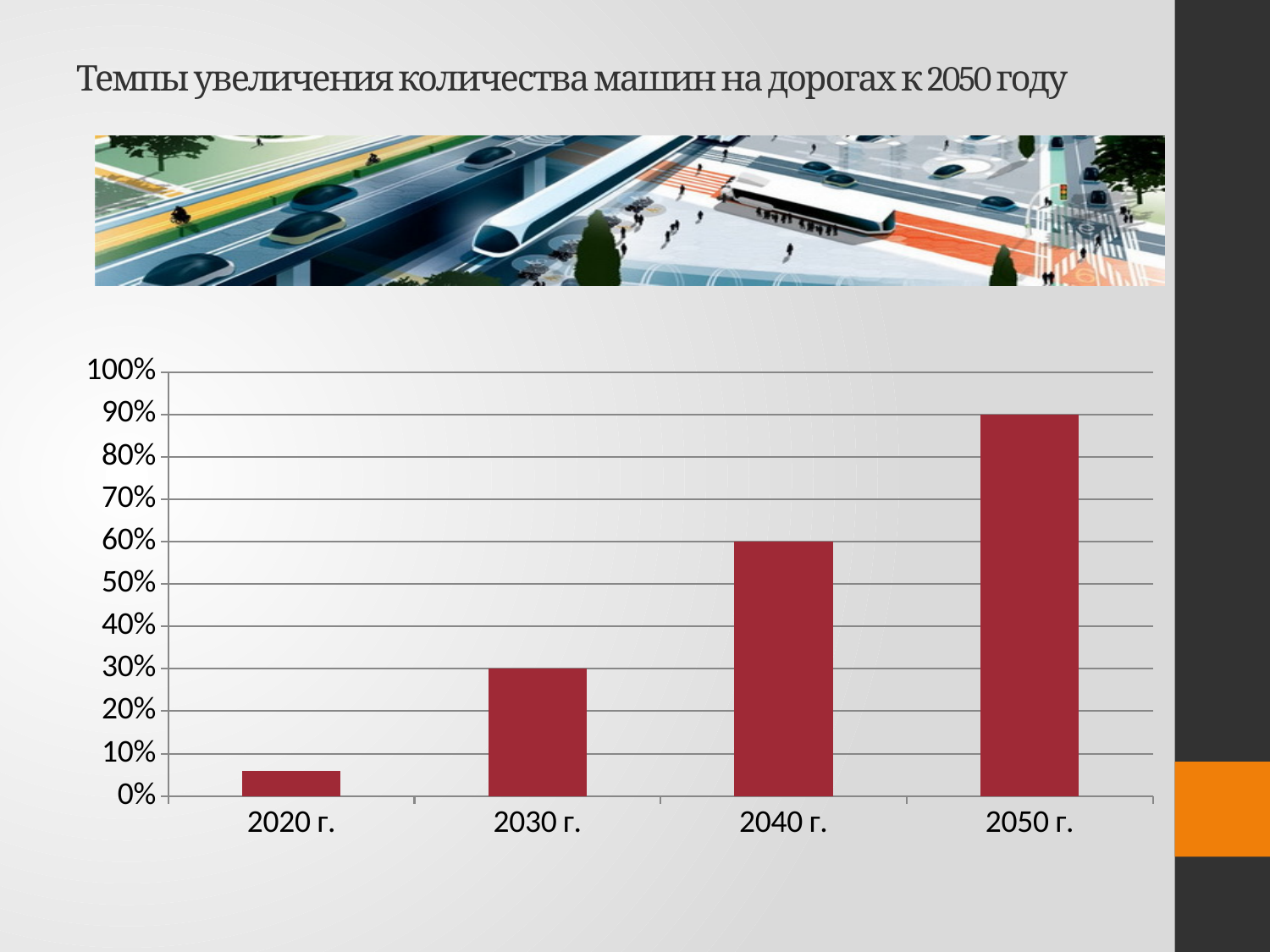
What is the value for 2040 г. in the chart? 60% How many categories (years) are shown on the x axis of the chart? 4 Which year has the lowest bar in the chart? 2020 г. What is the difference between the values for 2050 г. and 2040 г.? 30% Do the values rise or fall from 2020 г. to 2050 г. along the x axis? rise What is the value for 2050 г. in the chart? 90% What is the value for 2030 г. in the chart? 30% Which year has the highest bar in the chart? 2050 г. Which is larger, the value for 2030 г. or the value for 2040 г.? 2040 г. What kind of chart is shown on the slide? bar chart Is the value for 2020 г. greater or less than 10%? less What is the title of the slide with the chart? Темпы увеличения количества машин на дорогах к 2050 году